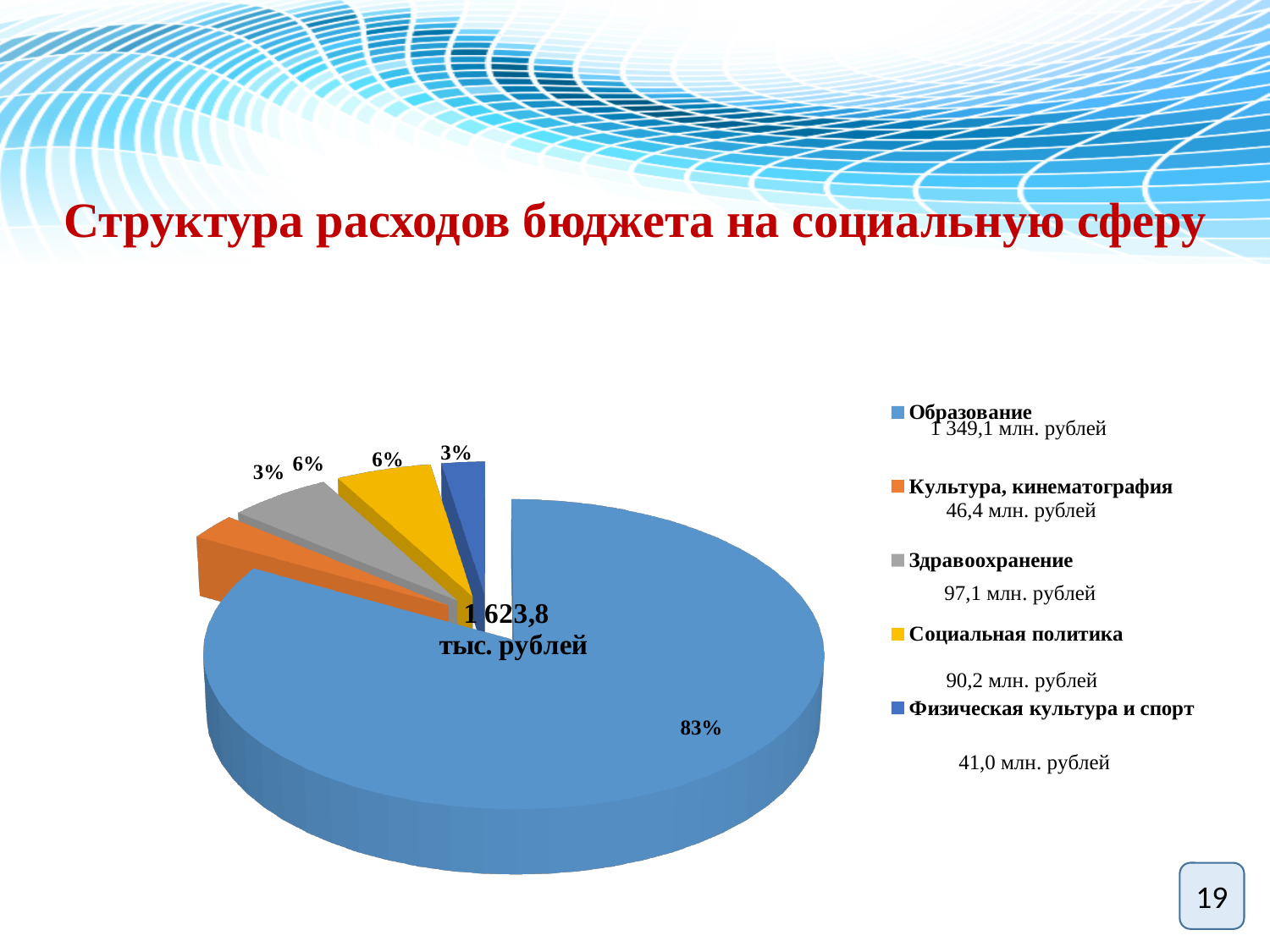
What amount is shown in the legend for Образование? 1 349,1 млн. рублей What is the title of the slide's chart? Структура расходов бюджета на социальную сферу What amount is shown in the legend for Физическая культура и спорт? 41,0 млн. рублей Which has the larger share: Здравоохранение or Культура, кинематография? Здравоохранение What total value is printed in the centre of the pie chart? 1 623,8 тыс. рублей How many categories does the legend of the pie chart list? 5 How many slices does the pie chart have? 5 What share of the pie does Образование take? 83% What kind of chart is shown on the slide? pie chart What share of the pie does Здравоохранение take? 6% Which category has the largest share of the pie? Образование What is the difference in percentage points between the share of Образование and the share of Социальная политика? 77